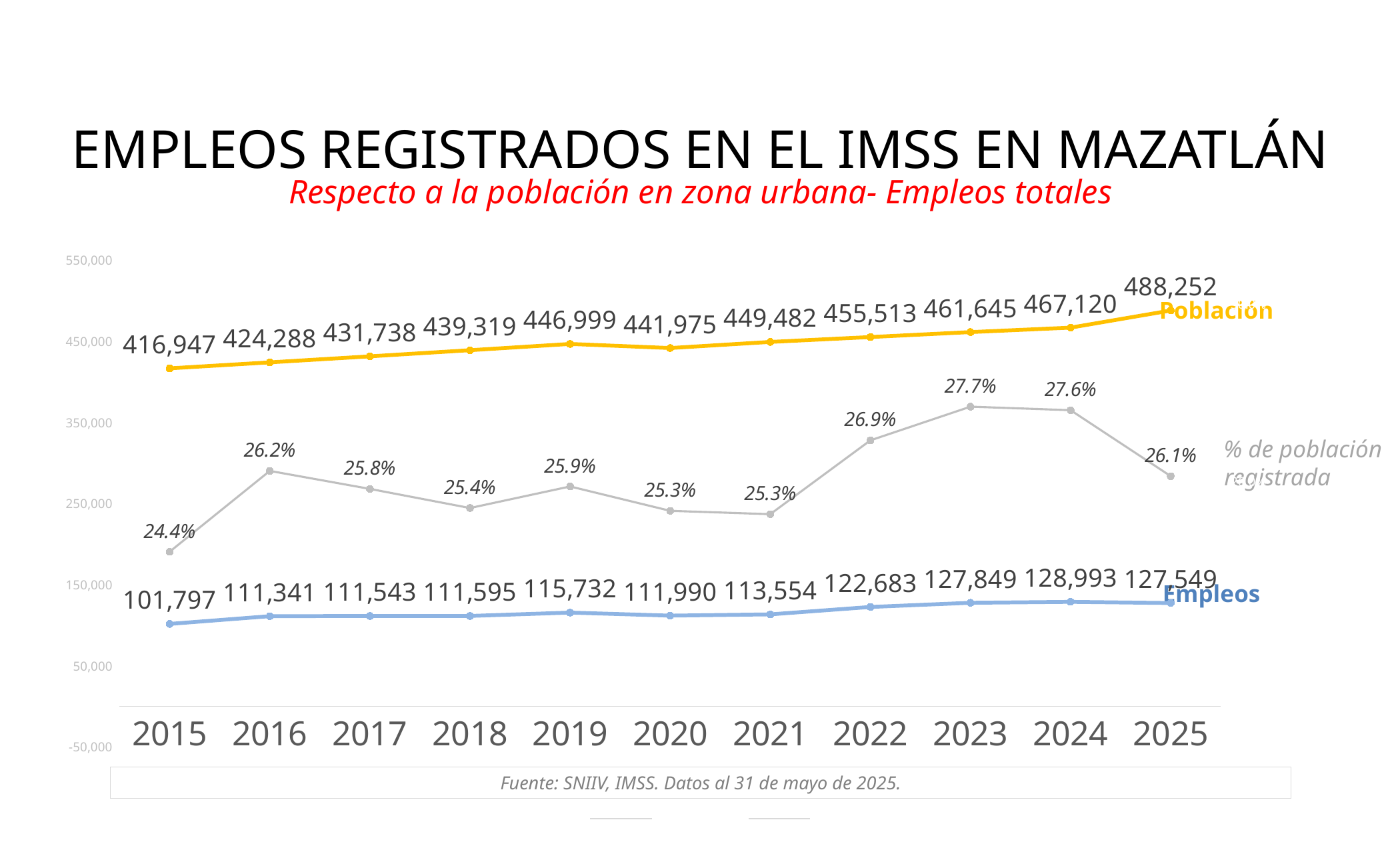
What colour is the Población line? yellow Does the Población series generally rise or fall from 2015 to 2025? rise How many series are plotted on the chart? 3 In which year is the Empleos series highest? 2024 What is the Población value for 2015? 416,947 In which year is the % de población registrada series lowest? 2015 What is the % de población registrada value for 2023? 27.7% How many years are shown on the x axis? 11 What kind of chart is shown on the slide? line chart What is the difference between the Población values for 2025 and 2024? 21,132 What is the Empleos value for 2024? 128,993 Which is larger, the Empleos value for 2019 or for 2020? 2019